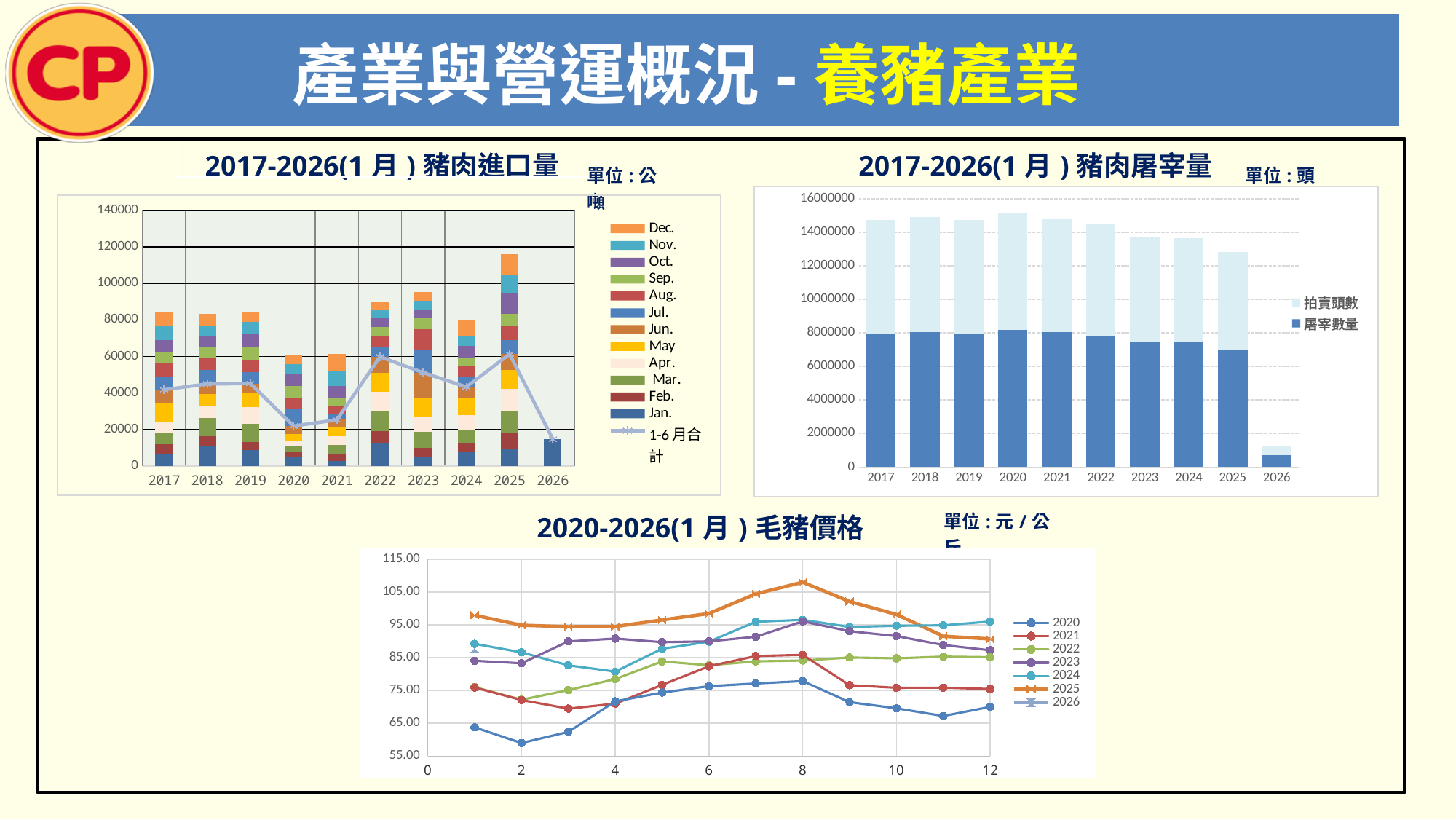
In the 2017-2026(1月)豬肉進口量 chart, is the total stacked bar for 2025 greater or less than 100000? greater In the 2017-2026(1月)豬肉進口量 chart, which year has the tallest stacked bar? 2025 In the 2017-2026(1月)豬肉屠宰量 chart, is the 屠宰數量 value for 2025 greater or less than 8000000? less In the 2017-2026(1月)豬肉屠宰量 chart, which year has the lowest total? 2026 In the 2017-2026(1月)豬肉屠宰量 chart, is the total for 2017 greater or less than 14000000? greater What kind of chart is the 2020-2026(1月)毛豬價格 chart at the bottom? line chart What kind of chart is the 2017-2026(1月)豬肉進口量 chart on the left? stacked bar chart with a line How many series does the legend of the 2020-2026(1月)毛豬價格 chart list? 7 In the 2017-2026(1月)豬肉進口量 chart, how many years are shown on the x axis? 10 How many series does the legend of the 2017-2026(1月)豬肉屠宰量 chart list? 2